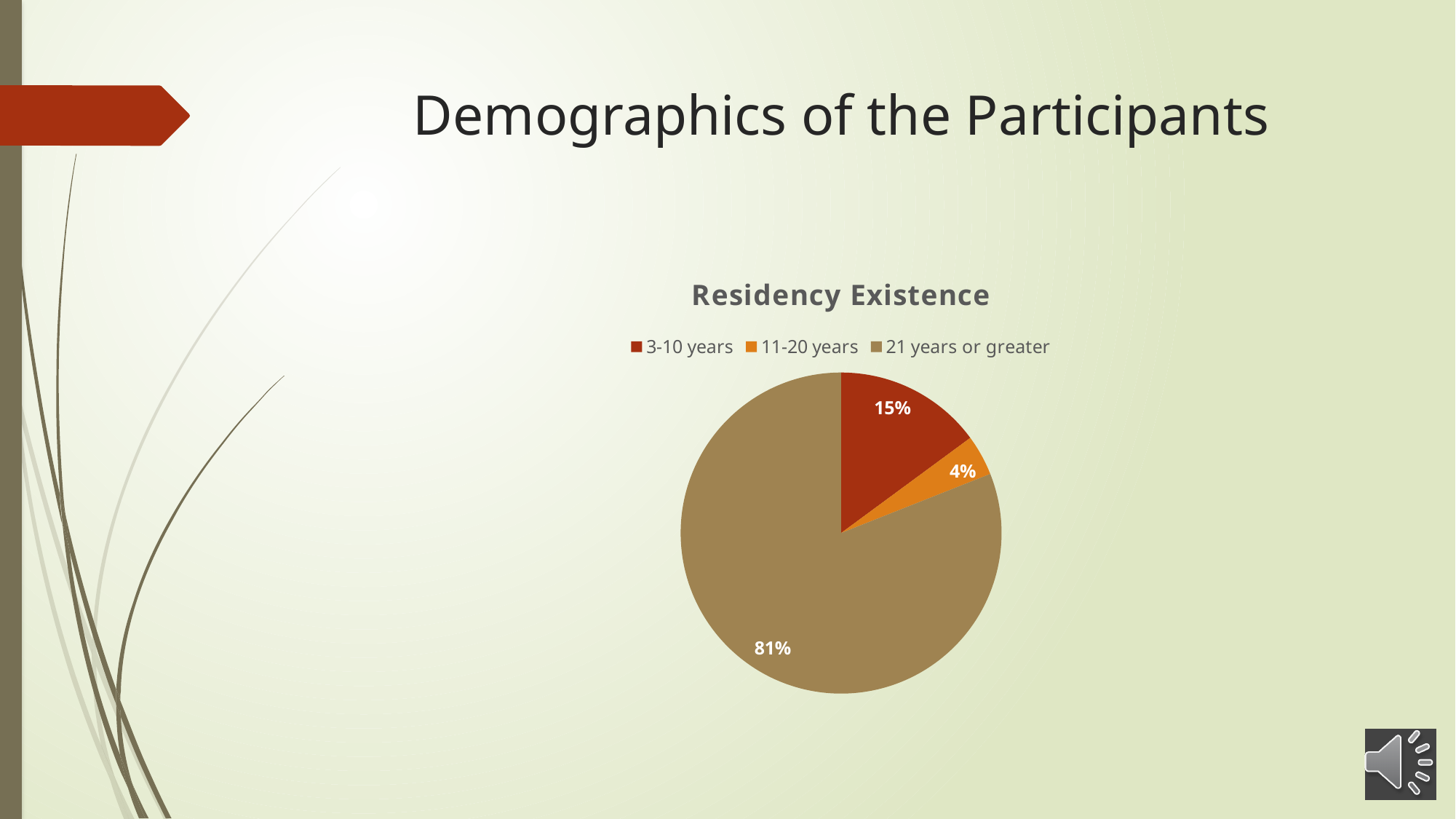
Which slice is larger, 3-10 years or 11-20 years? 3-10 years What share of the pie is labelled for 21 years or greater? 81% What colour is the slice for 11-20 years? orange What kind of chart is shown on the slide? pie chart What is the difference in percentage points between the 21 years or greater slice and the 3-10 years slice? 66 What share of the pie is labelled for 3-10 years? 15% How many entries does the legend list? 3 What share of the pie is labelled for 11-20 years? 4% How many categories does the pie chart show? 3 Which category has the smallest slice of the pie? 11-20 years Which category has the largest slice of the pie? 21 years or greater What is the title of the chart? Residency Existence